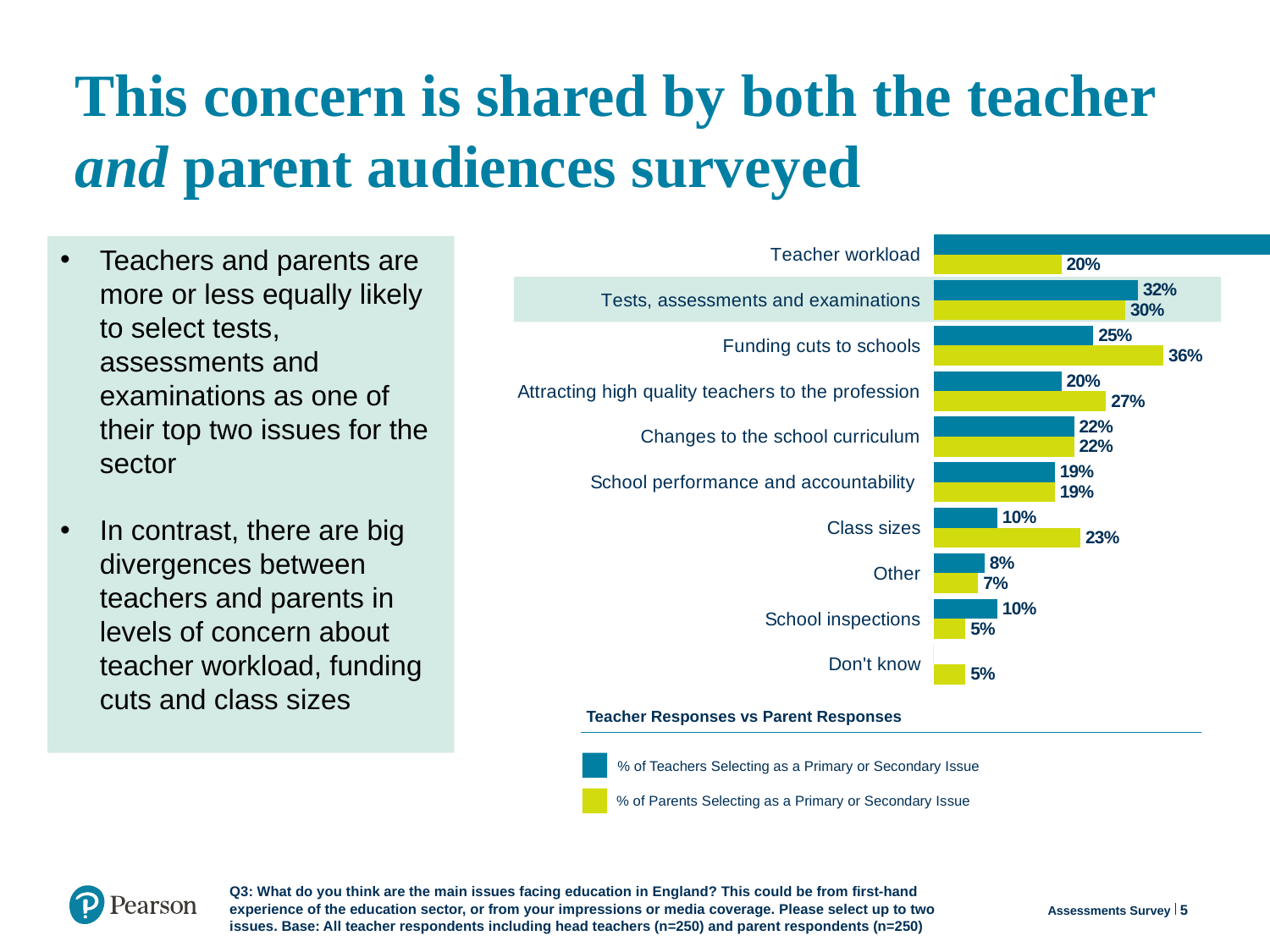
What is the title shown beneath the chart? Teacher Responses vs Parent Responses For 'School inspections', which is larger: the teacher percentage or the parent percentage? the teacher percentage What percentage of teachers selected 'Tests, assessments and examinations' as a primary or secondary issue? 32% How many series does the legend list? 2 Which issue has the highest percentage among parent responses? Funding cuts to schools What kind of chart is shown on the slide? bar chart What is the difference between the teacher and parent percentages for 'Funding cuts to schools'? 11% How many issue categories are shown in the chart? 10 Which issue has the highest percentage among teacher responses? Teacher workload What is the difference between the parent and teacher percentages for 'Class sizes'? 13% What percentage of parents selected 'Teacher workload'? 20% What percentage of parents selected 'Funding cuts to schools' as a primary or secondary issue? 36%